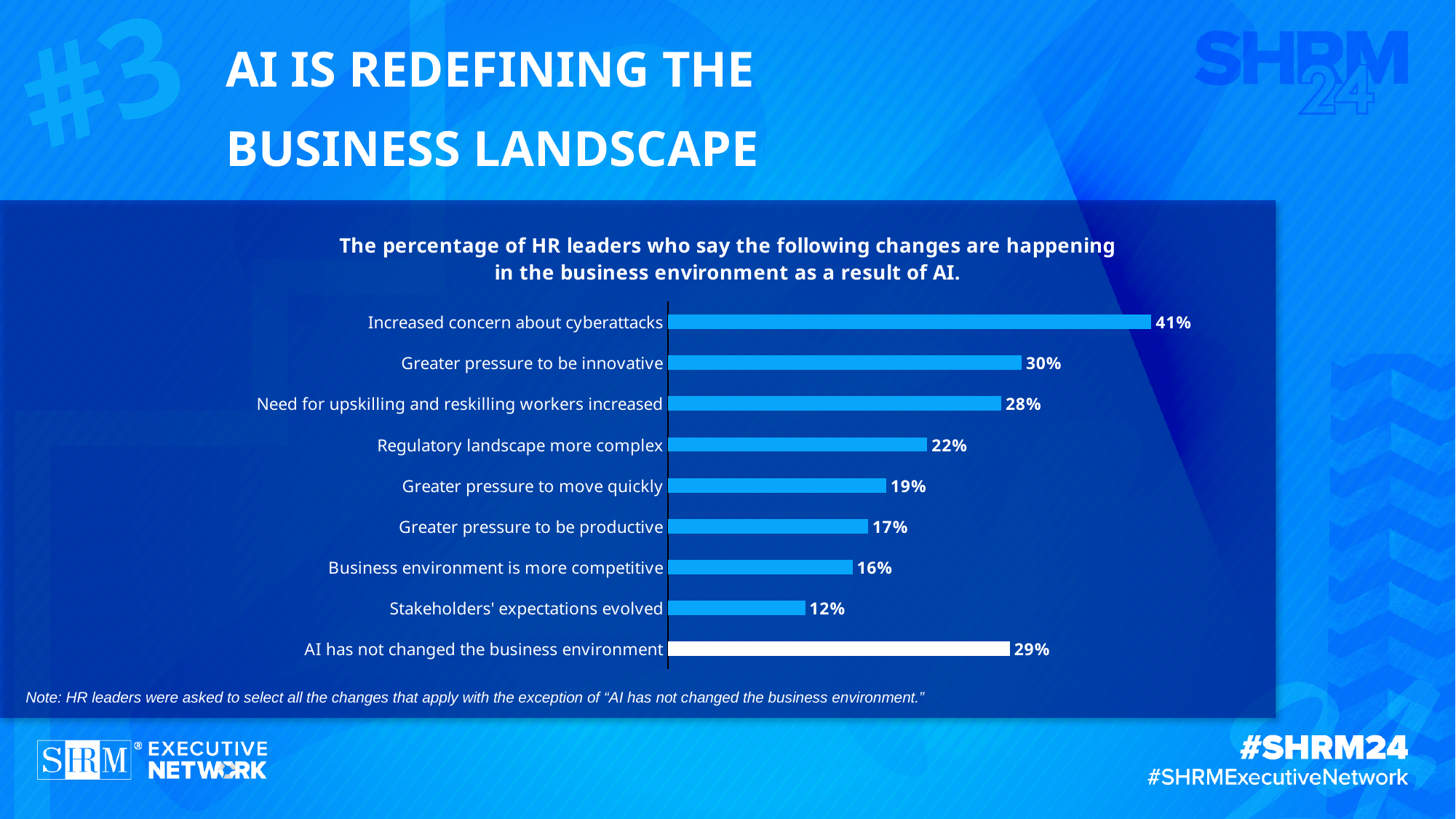
What is the difference between 'Increased concern about cyberattacks' and 'AI has not changed the business environment'? 12% What is the difference between 'Greater pressure to be innovative' and 'Need for upskilling and reskilling workers increased'? 2% Which category has the lowest percentage on the chart? Stakeholders' expectations evolved Which change has the highest percentage of HR leaders? Increased concern about cyberattacks What percentage of HR leaders say there is increased concern about cyberattacks as a result of AI? 41% What is the value for 'Regulatory landscape more complex'? 22% What is the value for 'Stakeholders' expectations evolved'? 12% Which is larger: 'Greater pressure to move quickly' or 'Greater pressure to be productive'? Greater pressure to move quickly What kind of chart is shown on the slide? Bar chart Which bar on the chart is coloured white rather than blue? AI has not changed the business environment What percentage of HR leaders say AI has not changed the business environment? 29% How many categories are shown on the chart? 9